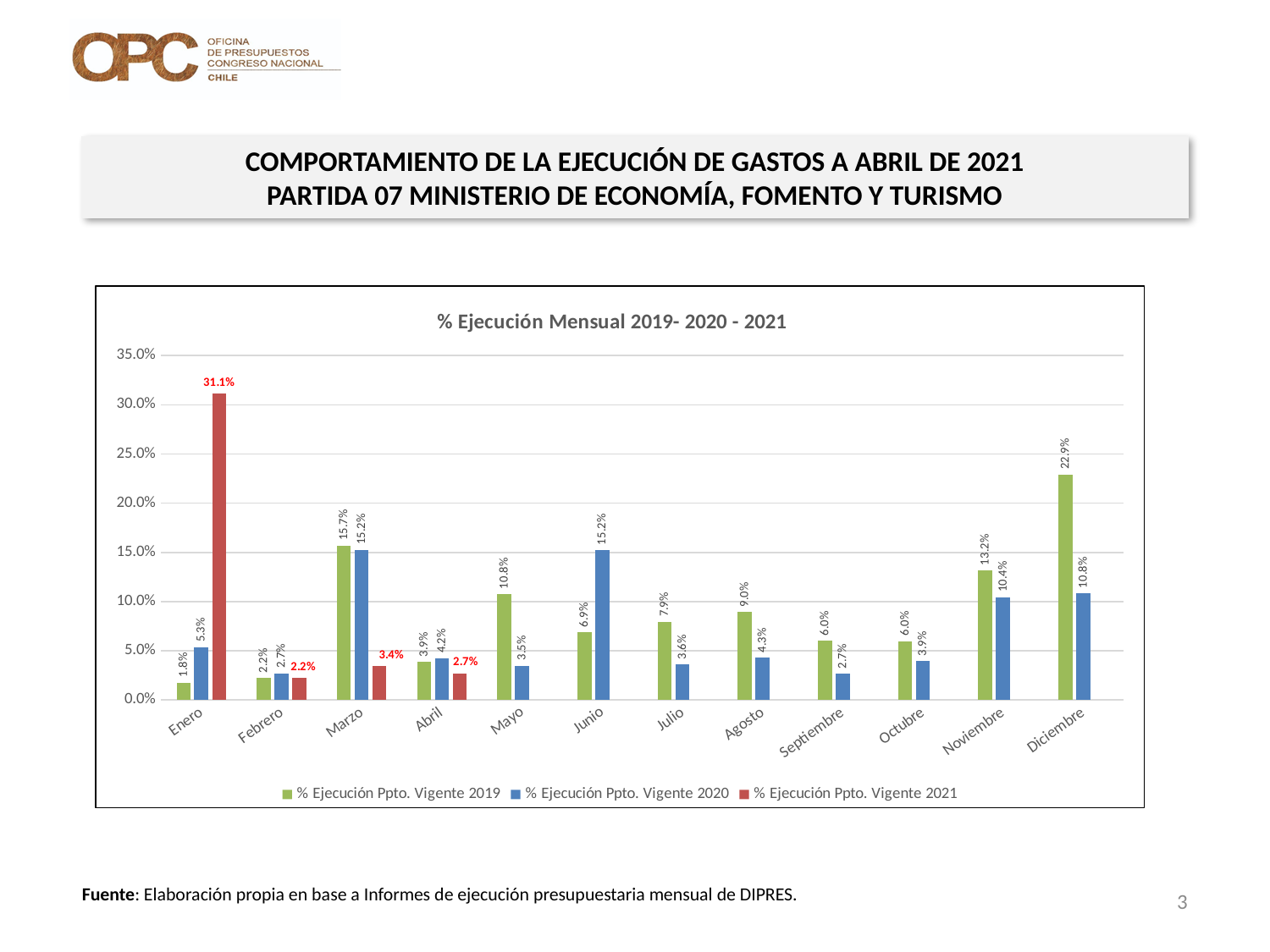
What kind of chart is shown on the slide? Bar chart What is the value for % Ejecución Ppto. Vigente 2020 in Junio? 15.2% Which month has the highest value for % Ejecución Ppto. Vigente 2019? Diciembre What is the value for % Ejecución Ppto. Vigente 2021 in Marzo? 3.4% How many series does the legend list? 3 Which is larger in Junio: the 2019 value or the 2020 value? 2020 What is the title of the chart? % Ejecución Mensual 2019- 2020 - 2021 Which month has the lowest value for % Ejecución Ppto. Vigente 2019? Enero How many months are shown on the x axis? 12 What is the difference between the 2019 and 2020 values in Diciembre? 12.1% What is the value for % Ejecución Ppto. Vigente 2019 in Diciembre? 22.9% What is the value for % Ejecución Ppto. Vigente 2021 in Enero? 31.1%